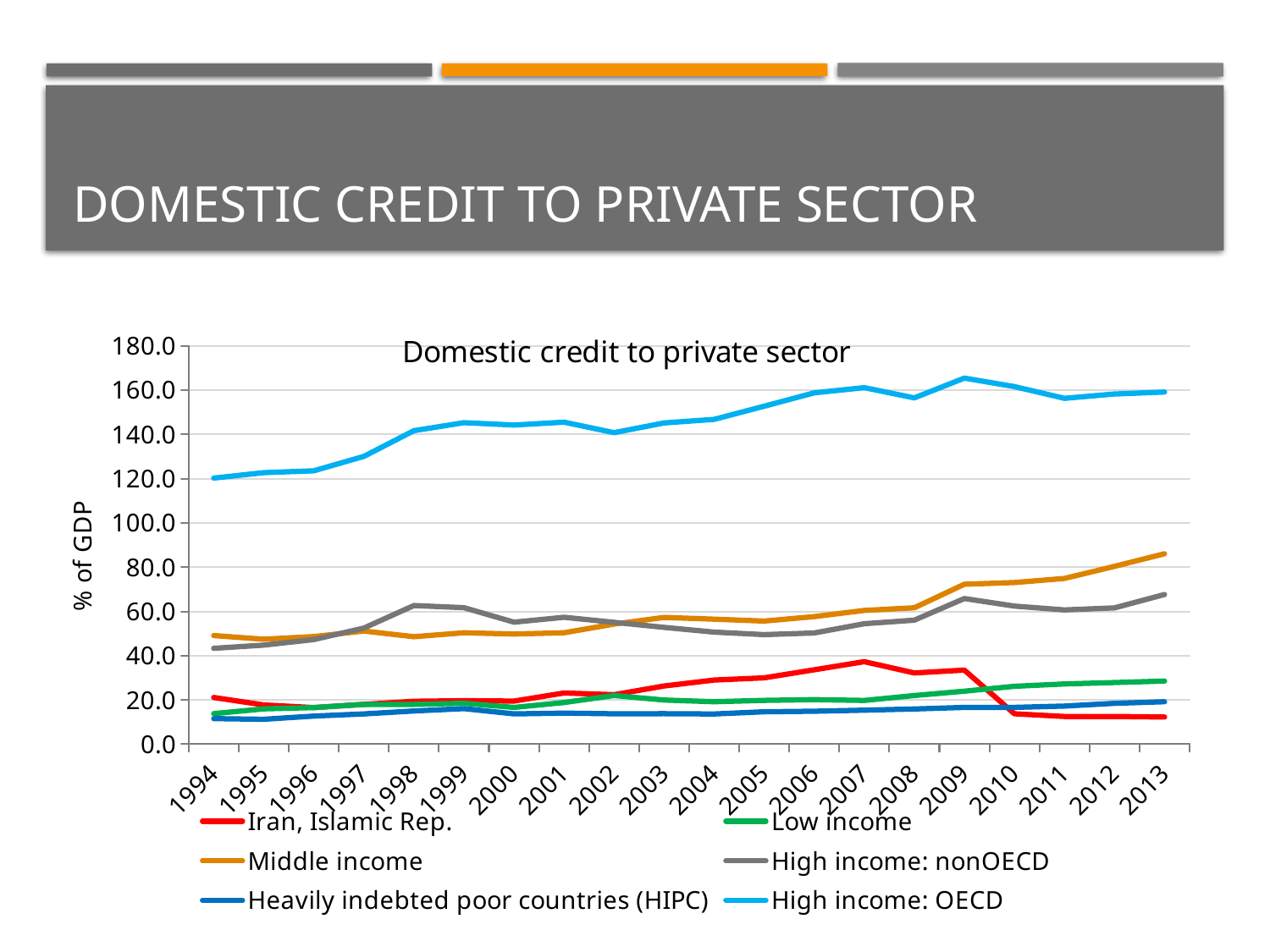
How many series does the legend list? 6 Which series has the highest value in 2013? High income: OECD Is the value for Middle income in 2013 greater or less than 80? greater What kind of chart is shown on the slide? line chart Which is larger in 2007, Iran, Islamic Rep. or Low income? Iran, Islamic Rep. How many years are shown along the x axis? 20 Which series has the lowest value in 2013? Iran, Islamic Rep. Which is larger in 2013, Middle income or High income: nonOECD? Middle income Is the value for High income: OECD in 1994 greater or less than 140? less What is the label on the y axis? % of GDP Does the Middle income line rise or fall from 2009 to 2013? rise Is the value for Iran, Islamic Rep. in 2013 greater or less than 20? less